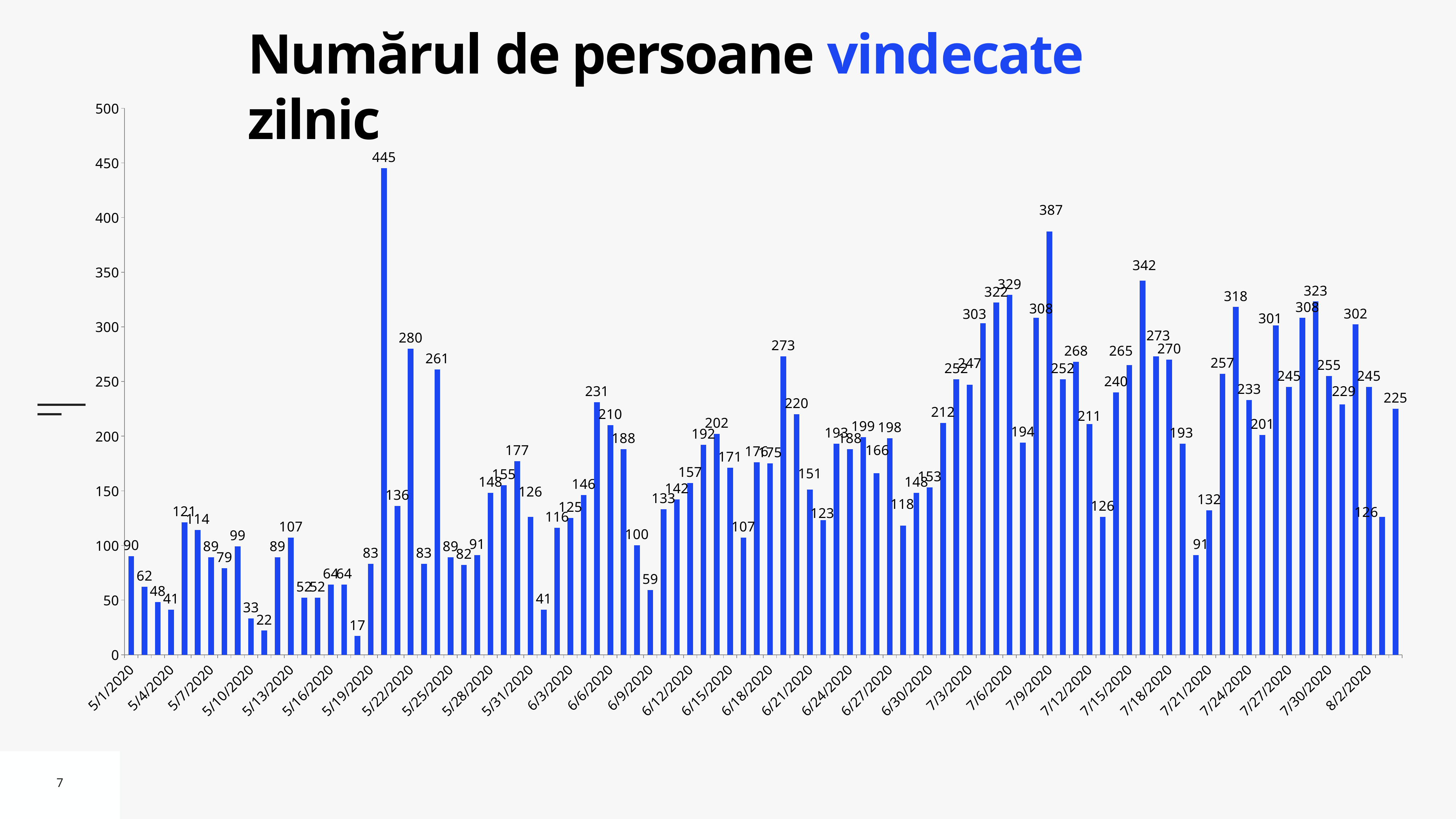
Do the values generally rise or fall from early May to mid July? rise Which is larger, the value for 6/6/2020 or the value for 6/3/2020? 6/6/2020 What is the value for 5/22/2020? 280 What is the difference between the values for 7/9/2020 and 5/22/2020? 107 What is the value for 7/6/2020? 329 What is the title of the chart? Numărul de persoane vindecate zilnic What is the value for 7/9/2020? 387 Is the value for 7/6/2020 greater or less than 300? greater Is the value for 5/10/2020 greater or less than 50? less What kind of chart is shown on the slide? bar chart What is the highest value shown on the chart? 445 What is the lowest value shown on the chart? 17